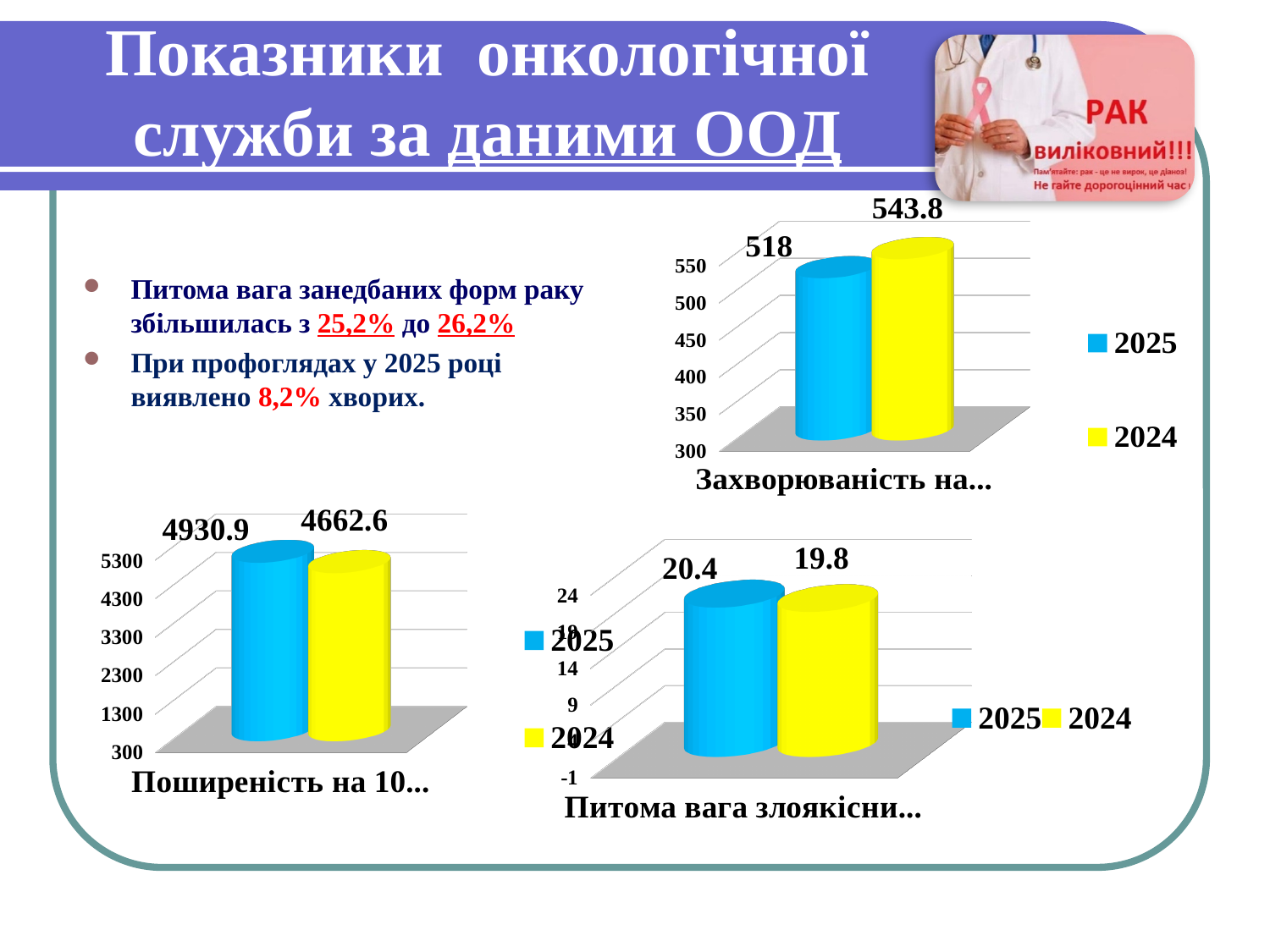
In the chart titled "Захворюваність на...", what is the value for 2025? 518 In the chart titled "Поширеність на 10...", which year has the lower value? 2024 In the chart titled "Захворюваність на...", what is the difference between the 2024 and 2025 values? 25.8 In the chart titled "Питома вага злоякісни...", how many series does the legend list? 2 In the chart titled "Захворюваність на...", what is the value for 2024? 543.8 In the chart titled "Поширеність на 10...", what is the value for 2025? 4930.9 In the chart titled "Захворюваність на...", which year has the higher value? 2024 In the chart titled "Питома вага злоякісни...", what is the value for 2025? 20.4 What type of chart is the chart titled "Захворюваність на..."? Bar chart In the chart titled "Поширеність на 10...", what is the value for 2024? 4662.6 In the chart titled "Питома вага злоякісни...", what is the value for 2024? 19.8 In the chart titled "Поширеність на 10...", what is the difference between the 2025 and 2024 values? 268.3